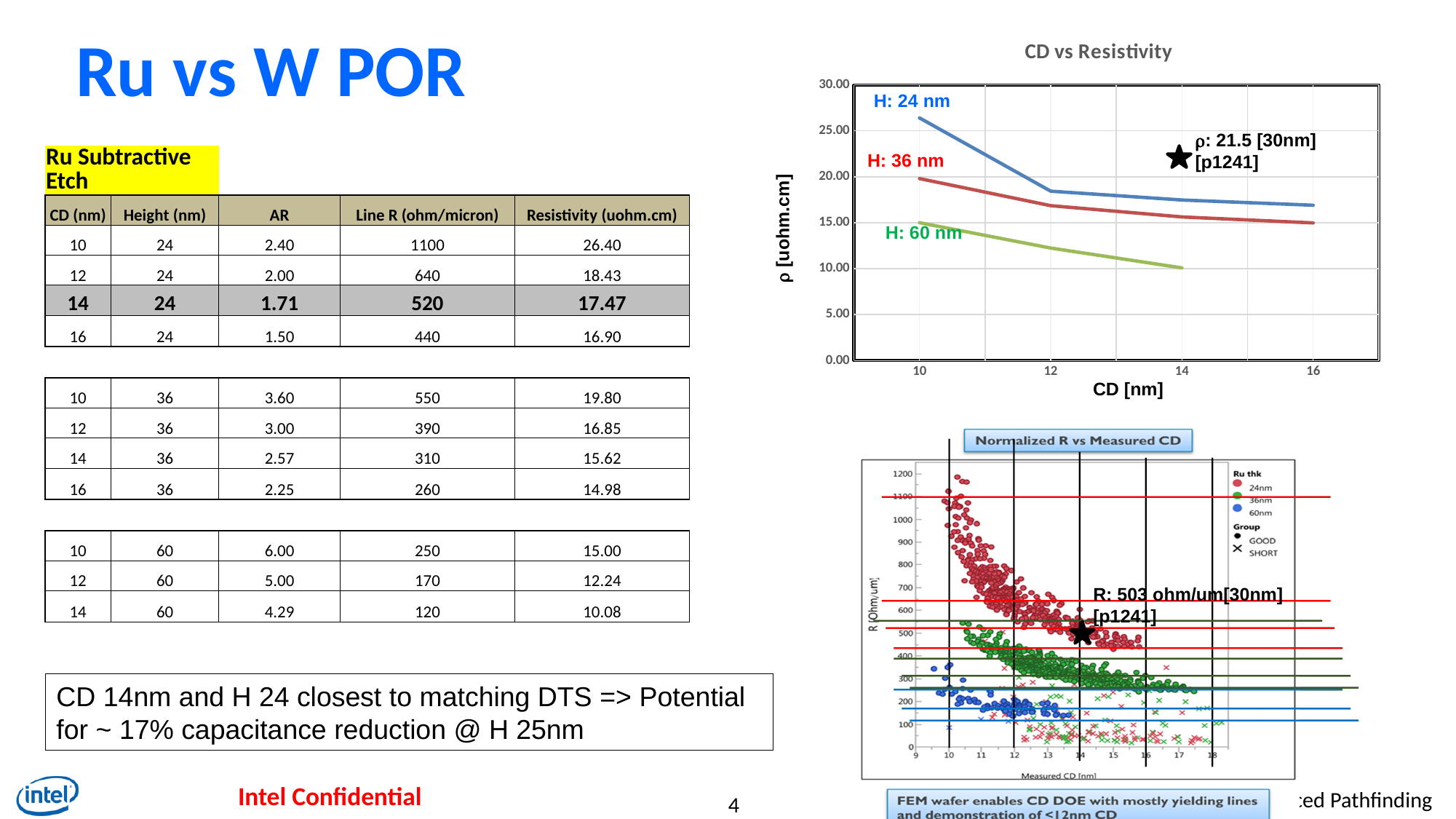
In the 'CD vs Resistivity' chart, is the value for H: 60 nm at CD 12 greater or less than 15.00? less In the 'CD vs Resistivity' chart, is the value for H: 36 nm at CD 12 greater or less than 15.00? greater In the 'CD vs Resistivity' chart, which series has the highest resistivity across the CD range? H: 24 nm In the 'CD vs Resistivity' chart, is the value for H: 24 nm at CD 10 greater or less than 25.00? greater In the 'Normalized R vs Measured CD' chart, what R value is annotated next to the star marker? 503 ohm/um In the 'CD vs Resistivity' chart, which series has the lowest resistivity? H: 60 nm In the 'CD vs Resistivity' chart, what resistivity value is annotated next to the star marker? 21.5 In the 'CD vs Resistivity' chart, what kind of chart is it? line chart In the 'Normalized R vs Measured CD' chart, what Ru thicknesses are listed in the legend? 24nm, 36nm, 60nm In the 'CD vs Resistivity' chart, how many CD points are plotted for the H: 60 nm series? 3 In the 'CD vs Resistivity' chart, does resistivity rise or fall as CD increases? fall In the 'CD vs Resistivity' chart, how many lines (series) are plotted? 3